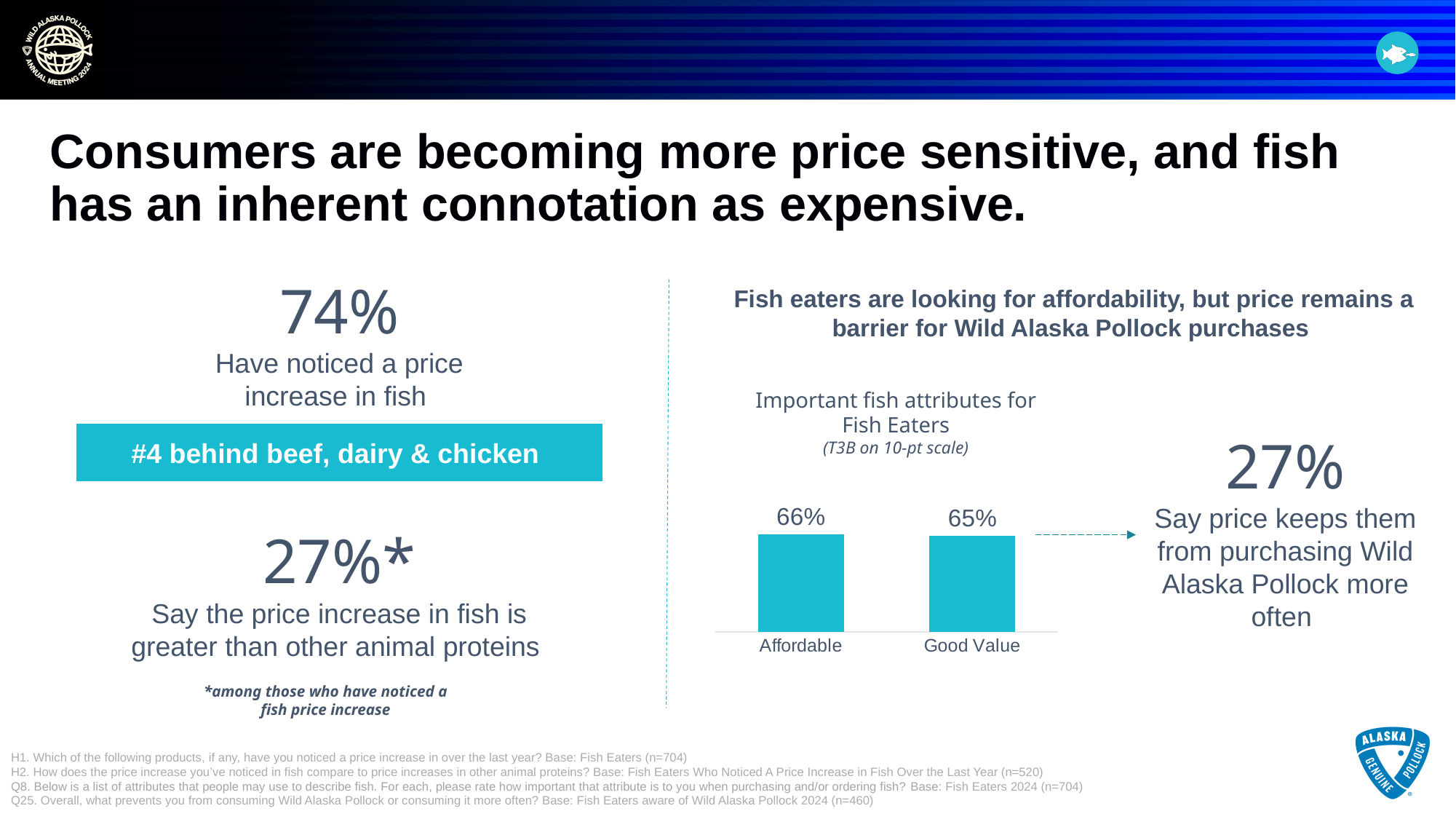
How many categories are shown in the Important fish attributes for Fish Eaters chart? 2 What scale note appears under the title of the Important fish attributes for Fish Eaters chart? T3B on 10-pt scale What is the value for Good Value in the Important fish attributes for Fish Eaters chart? 65% What is the value for Affordable in the Important fish attributes for Fish Eaters chart? 66% In the Important fish attributes for Fish Eaters chart, is the value for Affordable larger or smaller than the value for Good Value? larger What kind of chart is the Important fish attributes for Fish Eaters chart? bar chart What is the title of the chart on the slide? Important fish attributes for Fish Eaters What are the two categories on the x axis of the Important fish attributes for Fish Eaters chart? Affordable and Good Value Which attribute has the higher value in the Important fish attributes for Fish Eaters chart? Affordable Which attribute has the lower value in the Important fish attributes for Fish Eaters chart? Good Value What is the difference between the Affordable and Good Value values in the Important fish attributes for Fish Eaters chart? 1%